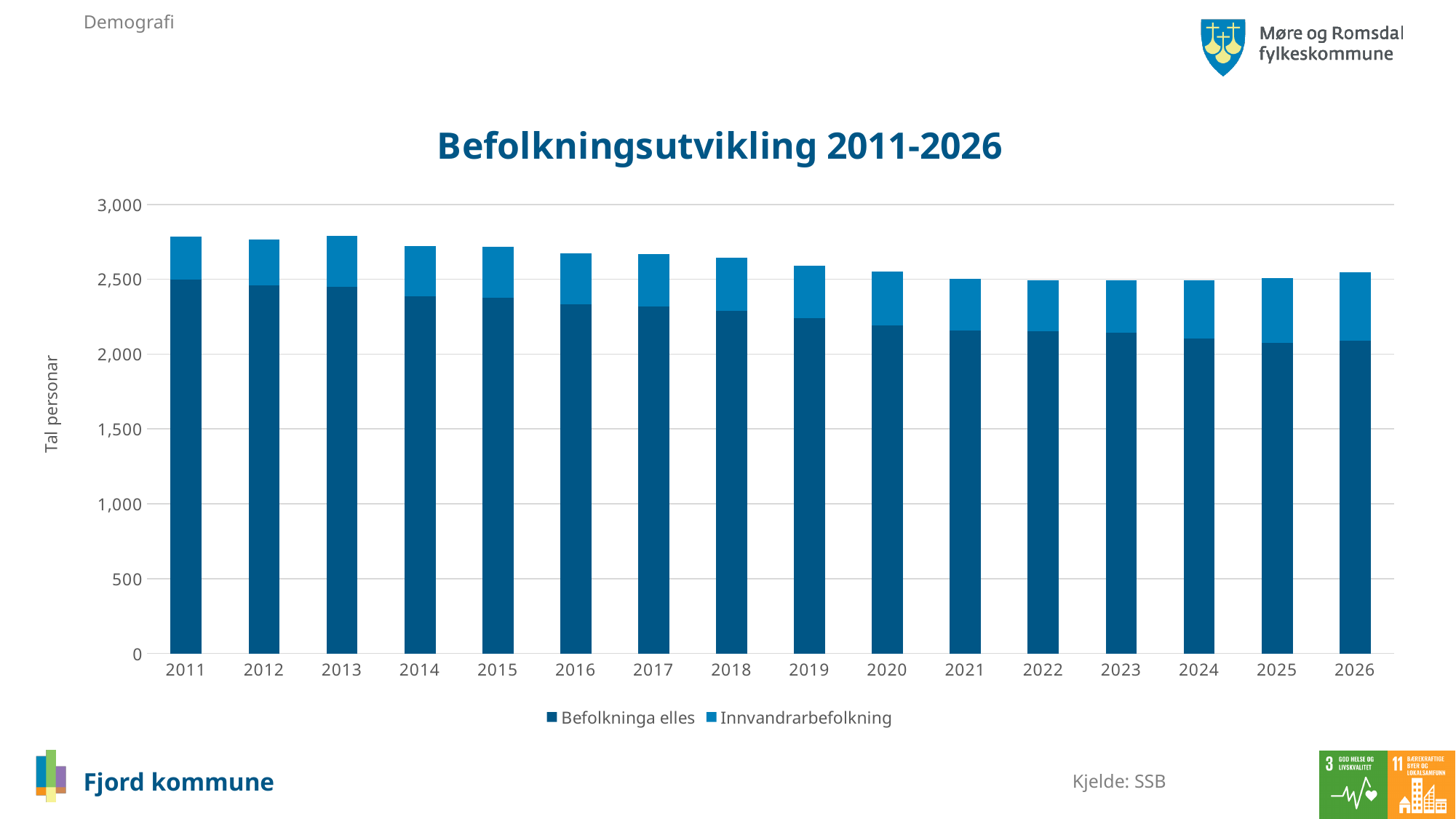
Is the value for Befolkninga elles in 2026 greater or less than 2,500? less Which is larger, Befolkninga elles in 2011 or Befolkninga elles in 2026? 2011 What is the label of the vertical axis? Tal personar Does the Befolkninga elles series rise or fall from 2011 to 2026? fall Is the value for Befolkninga elles in 2024 greater or less than 2,000? greater Is the total bar for 2011 greater or less than 2,500? greater What kind of chart is shown on the slide? Stacked bar chart Which is larger, Innvandrarbefolkning in 2011 or Innvandrarbefolkning in 2026? 2026 How many years are shown on the x axis? 16 What is the title of the chart? Befolkningsutvikling 2011-2026 How many series does the legend list? 2